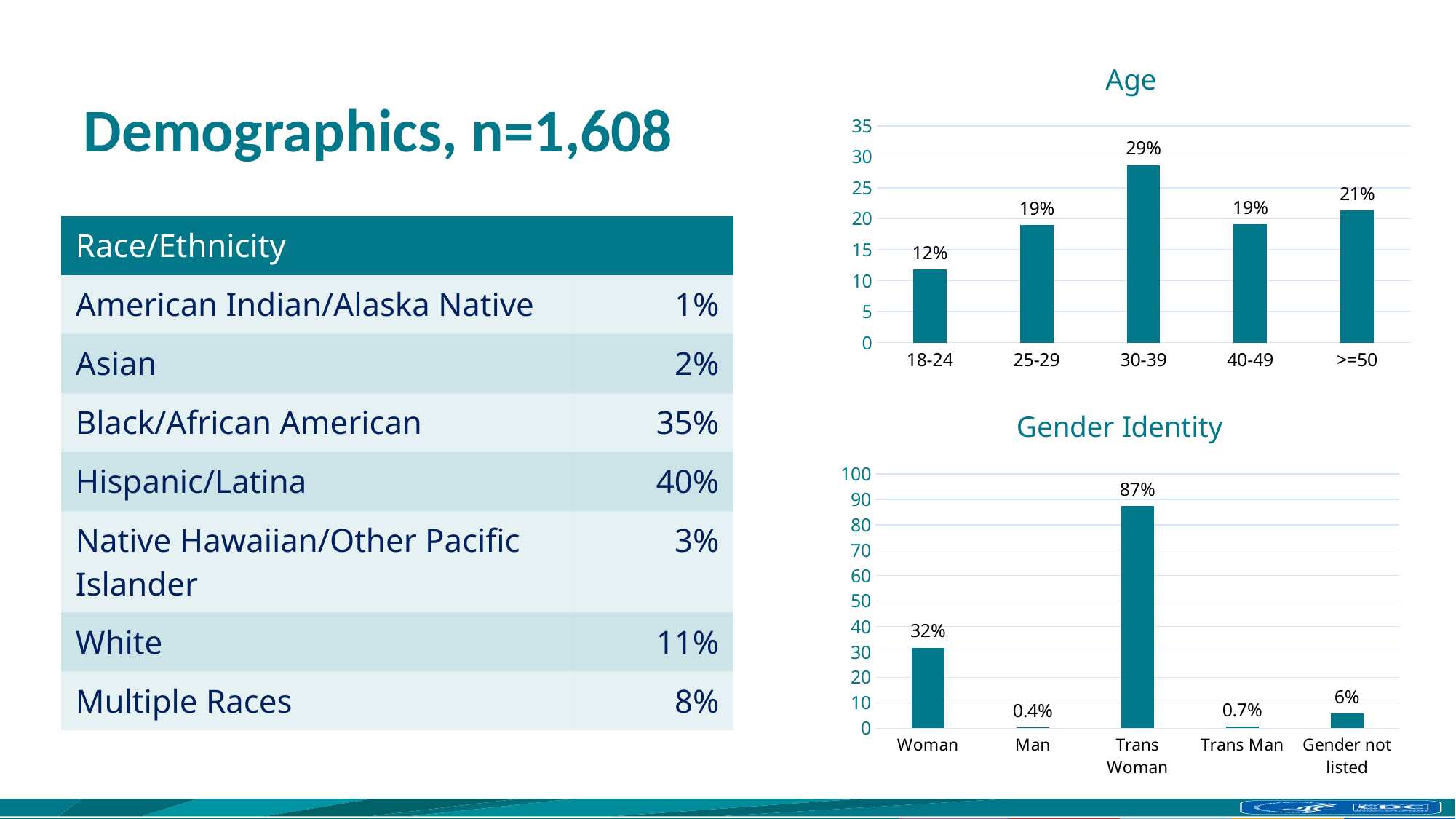
In the Age chart, which age group has the lowest value? 18-24 In the Gender Identity chart, what is the value for Trans Woman? 87% In the Gender Identity chart, which is larger, the value for Woman or the value for Gender not listed? Woman In the Age chart, what is the difference between the values for 30-39 and 18-24? 17% In the Age chart, what is the value for the 30-39 age group? 29% In the Age chart, is the value for >=50 greater or less than 25? less In the Gender Identity chart, what is the difference between the values for Trans Woman and Woman? 55% In the Age chart, which age group has the highest value? 30-39 In the Age chart, how many age groups are shown? 5 In the Gender Identity chart, which category has the highest value? Trans Woman In the Gender Identity chart, what is the value for Man? 0.4% What kind of chart is the Gender Identity chart? Bar chart